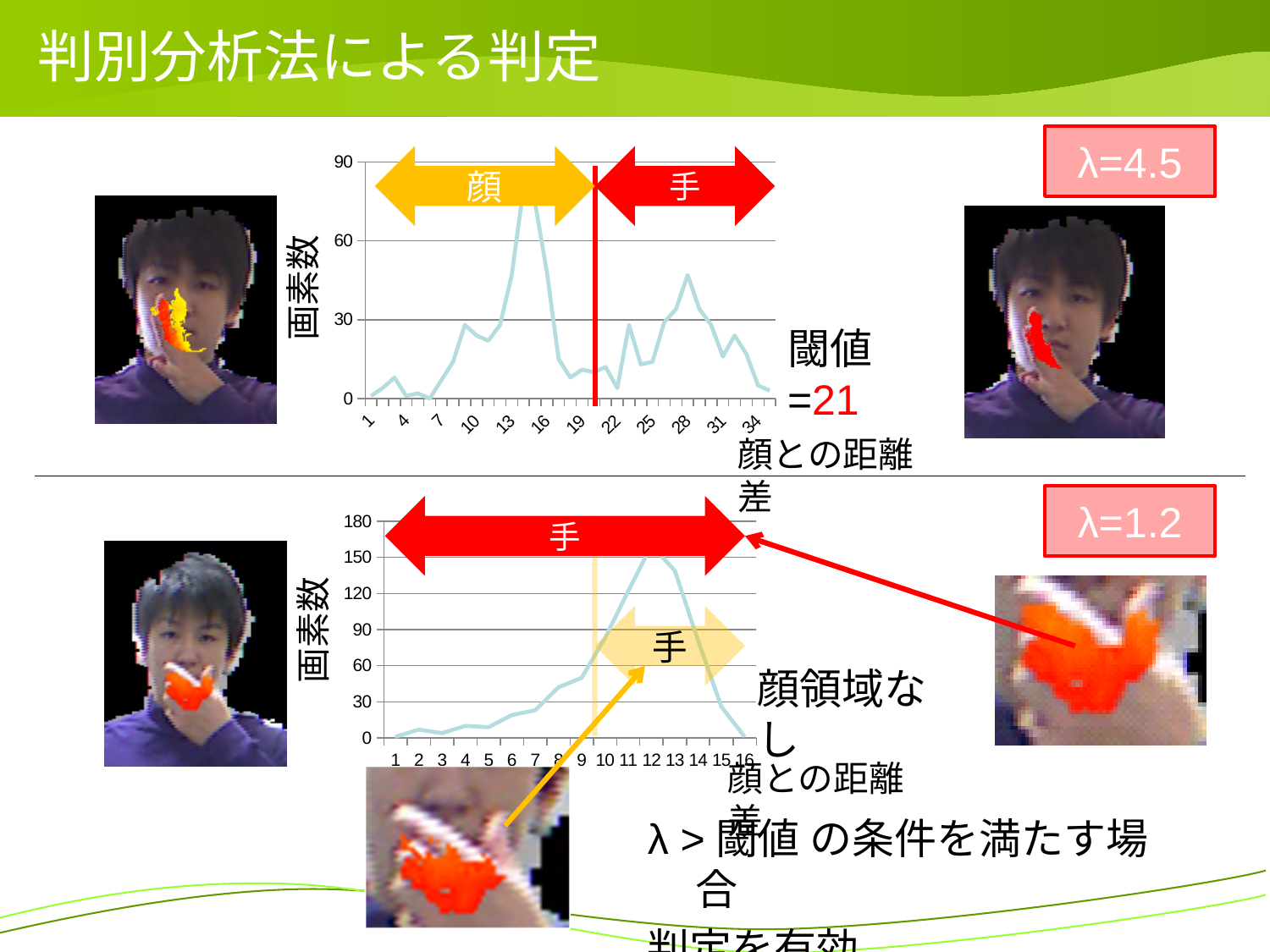
In the bottom chart, is the peak value of the line (around x = 12) greater or less than 120? greater What kind of chart is the bottom chart on the slide? line chart In the bottom chart, what is the highest value shown on the y axis? 180 In the top chart, which peak is higher: the one near x = 14 or the one near x = 28? the one near x = 14 In the bottom chart, does the line rise or fall from x = 12 to x = 16? fall In the top chart, what is the highest value shown on the y axis? 90 In the top chart, is the value at x = 1 greater or less than 30? less In the bottom chart, is the value at x = 1 greater or less than 30? less What kind of chart is the top chart on the slide? line chart In the bottom chart, does the line rise or fall from x = 1 to x = 12? rise In the bottom chart, how many x-axis categories are there? 16